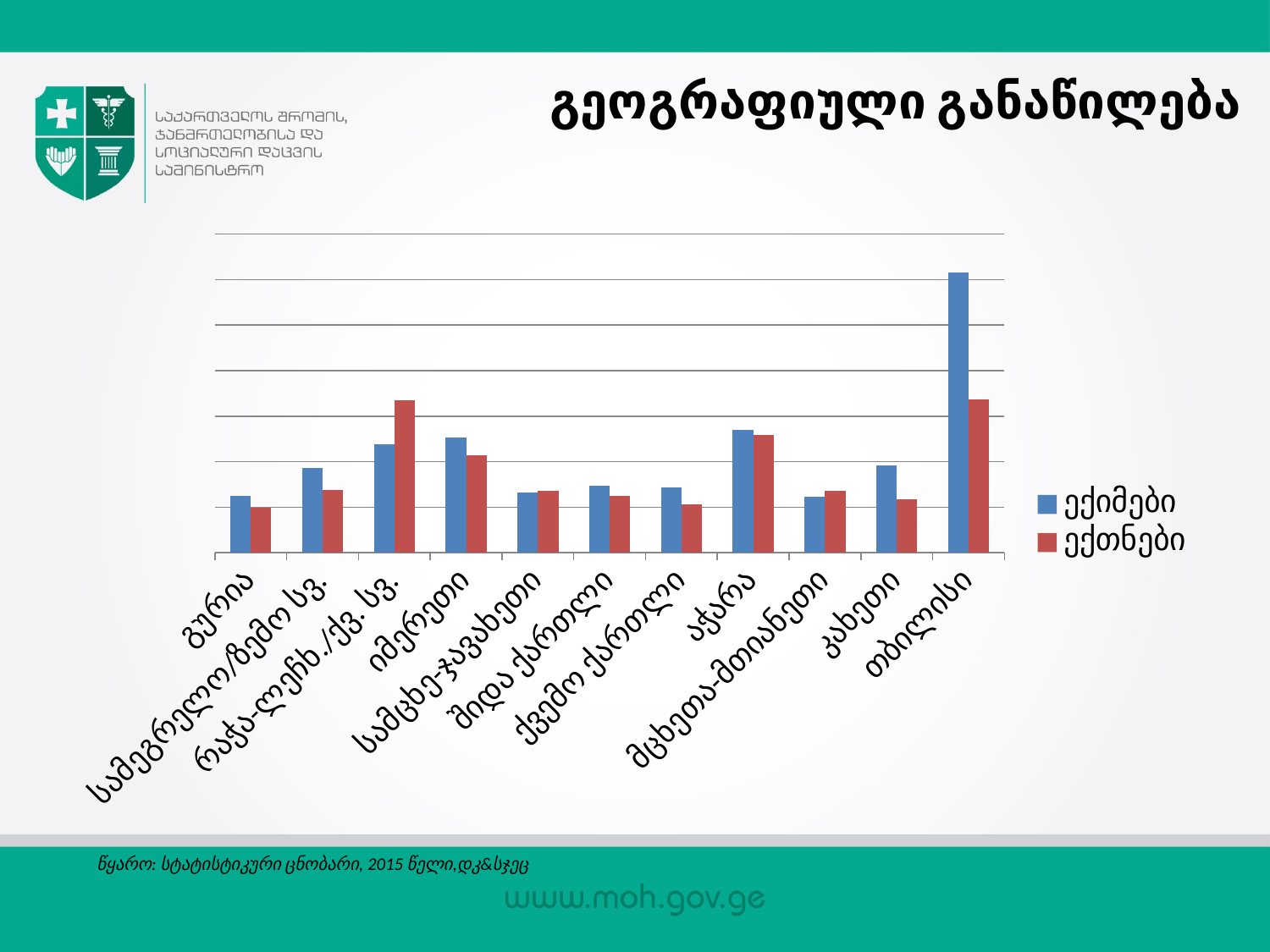
Which category has the highest value for ექთნები? თბილისი For იმერეთი, which is larger: ექიმები or ექთნები? ექიმები Which category has the highest value for ექიმები? თბილისი How many categories are shown on the x axis of the chart? 11 What is the title of the chart slide? გეოგრაფიული განაწილება How many series does the legend list? 2 What kind of chart is shown on the slide? bar chart For თბილისი, which is larger: ექიმები or ექთნები? ექიმები Which series is shown in red in the chart? ექთნები For კახეთი, which is larger: ექიმები or ექთნები? ექიმები